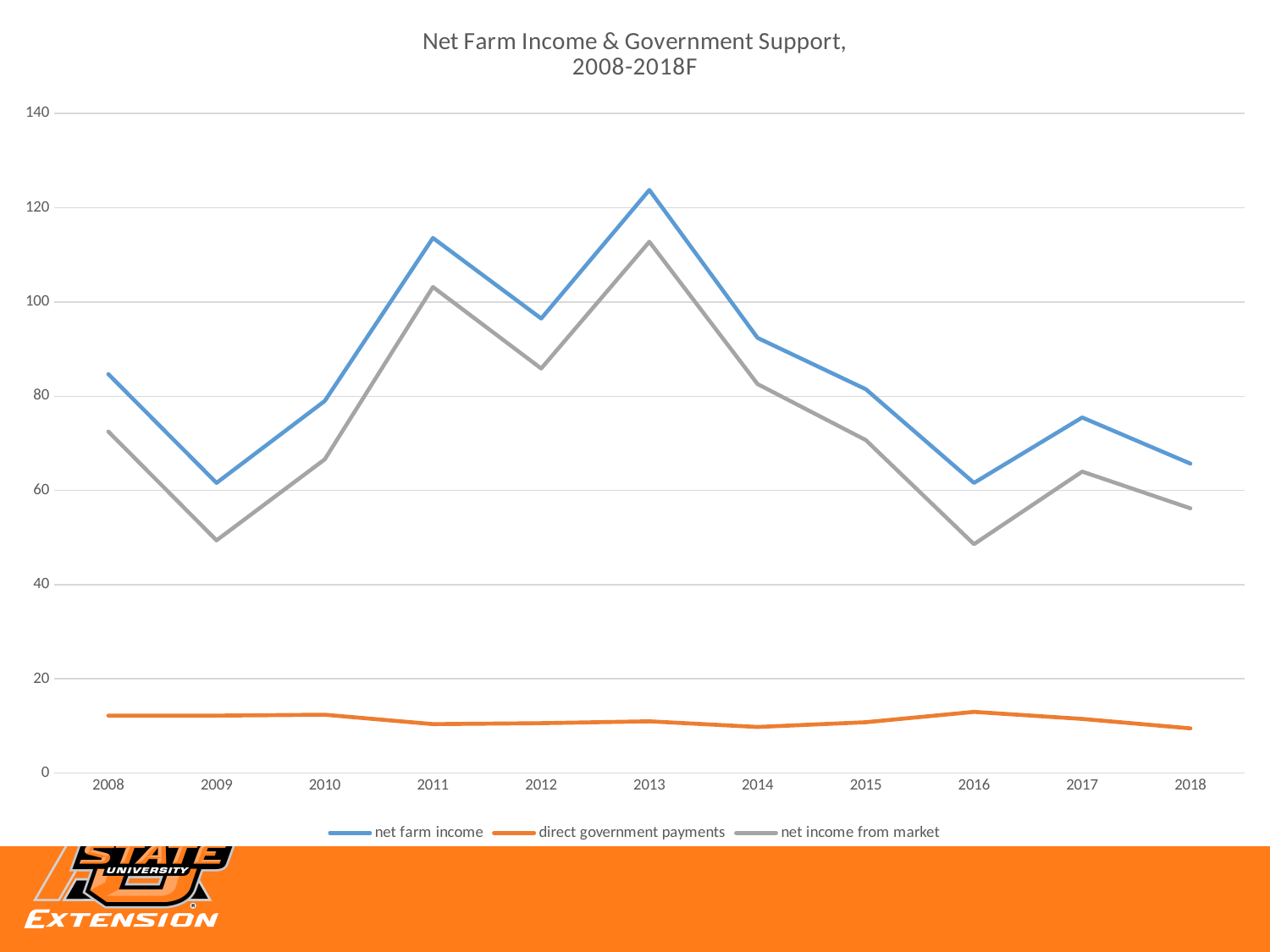
In which year does net farm income reach its highest value? 2013 What is the title of the chart? Net Farm Income & Government Support, 2008-2018F How many years are plotted along the x axis? 11 Is the value for net farm income in 2013 greater or less than 120? greater What kind of chart is shown on the slide? line chart Is the value for direct government payments in 2016 greater or less than 20? less Is the value for net income from market in 2009 greater or less than 60? less Which is larger, net farm income in 2011 or net farm income in 2012? 2011 Does net farm income rise or fall from 2013 to 2016? fall In which year does net income from market reach its highest value? 2013 How many series does the legend list? 3